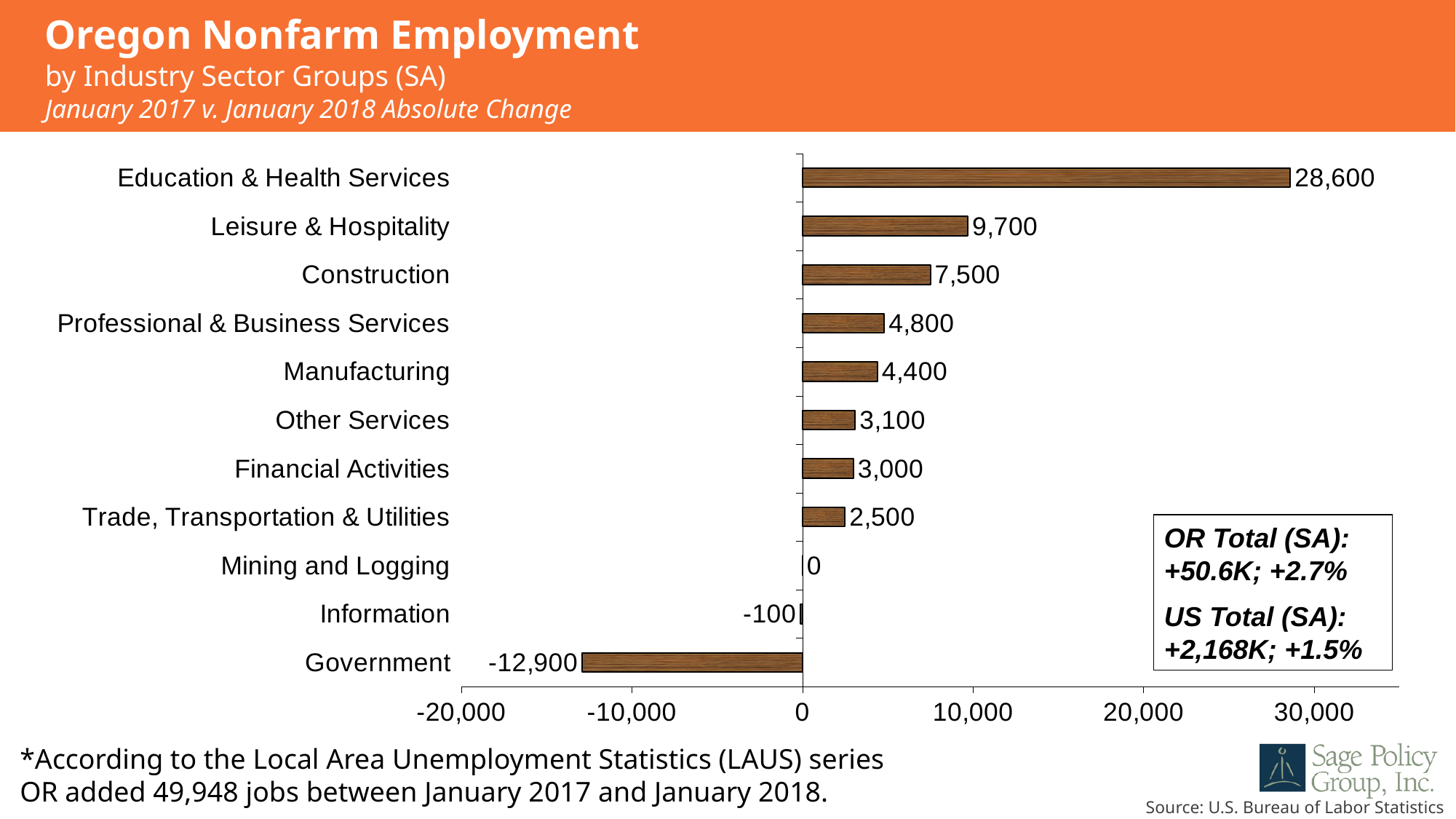
What is the absolute change in employment for Government? -12,900 What is the OR Total (SA) shown in the text box on the chart? +50.6K; +2.7% Which industry sector group has the highest absolute change? Education & Health Services How many industry sector groups are shown in the chart? 11 What is the absolute change in employment for Information? -100 Is the value for Education & Health Services greater or less than 20,000? greater Which industry sector group has the lowest absolute change? Government Which has a larger absolute change, Manufacturing or Professional & Business Services? Professional & Business Services What kind of chart is shown on the slide? Bar chart What is the absolute change in employment for Mining and Logging? 0 What is the absolute change in employment for Education & Health Services? 28,600 What is the difference between the absolute change for Leisure & Hospitality and Construction? 2,200